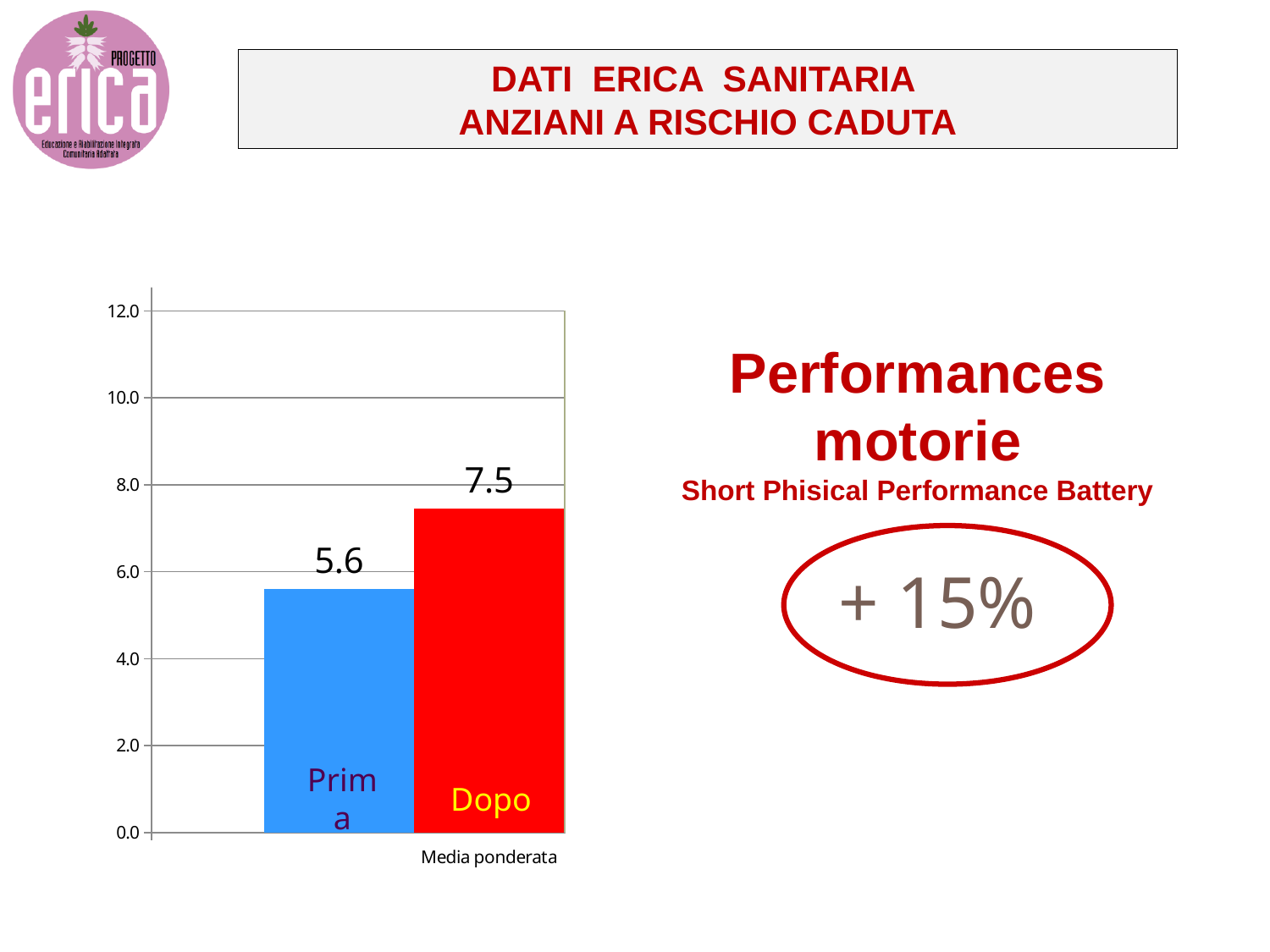
Is the value for Dopo greater or less than 8.0? less What is the label on the x axis of the chart? Media ponderata What is the difference between the Dopo and Prima values? 1.9 Which bar is higher, Prima or Dopo? Dopo Which bar is lower, Prima or Dopo? Prima What is the value of the Prima bar? 5.6 Is the value for Prima greater or less than 4.0? greater What is the value of the Dopo bar? 7.5 What kind of chart is shown on the slide? bar chart What is the highest value shown on the y axis? 12.0 What colour is the Dopo bar? red How many bars are shown in the chart? 2